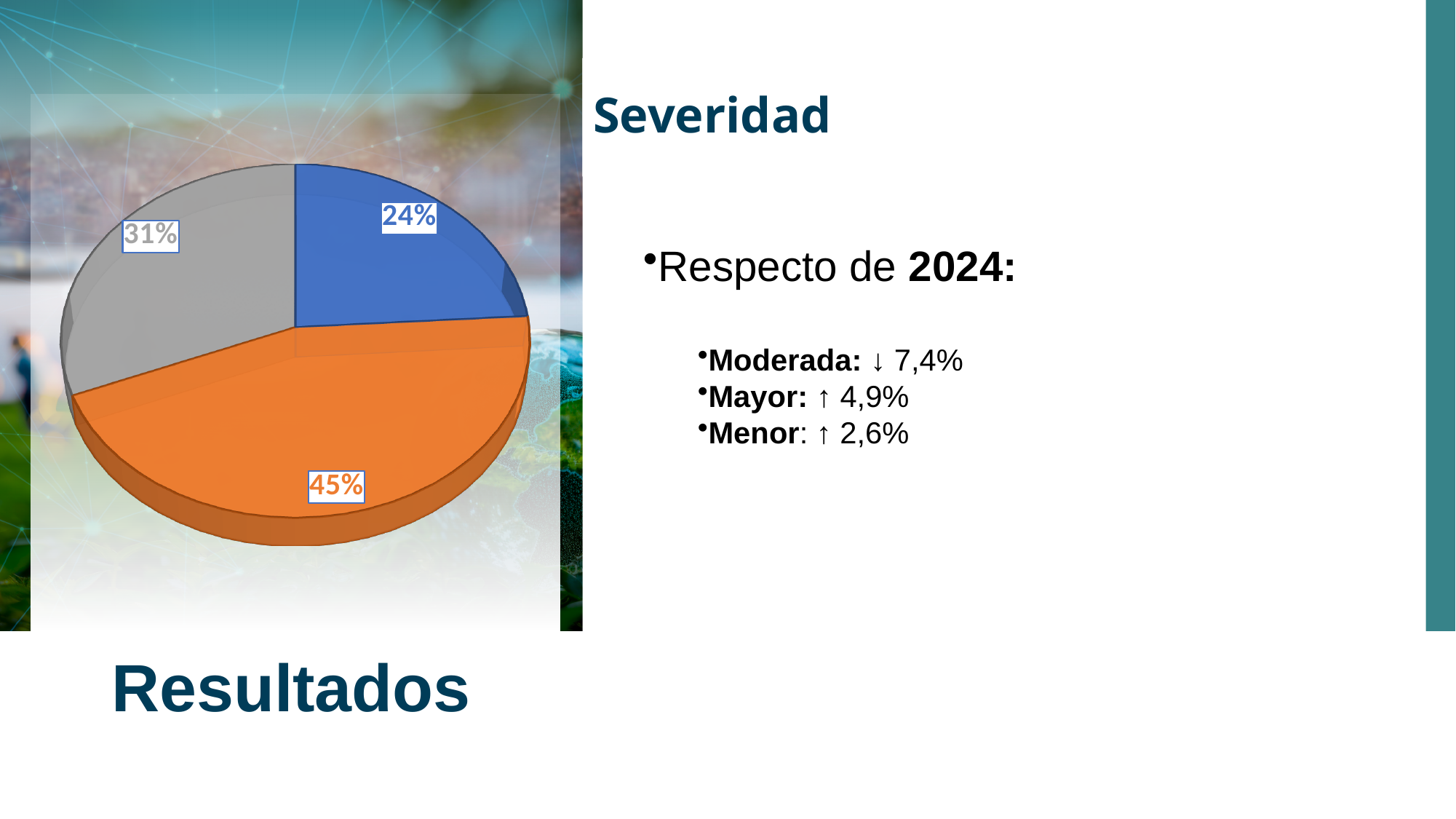
Is the orange slice's share of the pie greater or less than 40%? greater Which colour slice is the smallest in the pie chart? blue What is the heading shown next to the pie chart? Severidad Which is larger, the grey slice or the blue slice? grey slice What percentage is shown on the grey slice of the pie chart? 31% What percentage is shown on the orange slice of the pie chart? 45% What kind of chart is shown on the slide? pie chart What is the difference in percentage points between the orange slice and the blue slice? 21 What is the difference in percentage points between the grey slice and the blue slice? 7 How many slices does the pie chart have? 3 Which colour slice is the largest in the pie chart? orange What percentage is shown on the blue slice of the pie chart? 24%